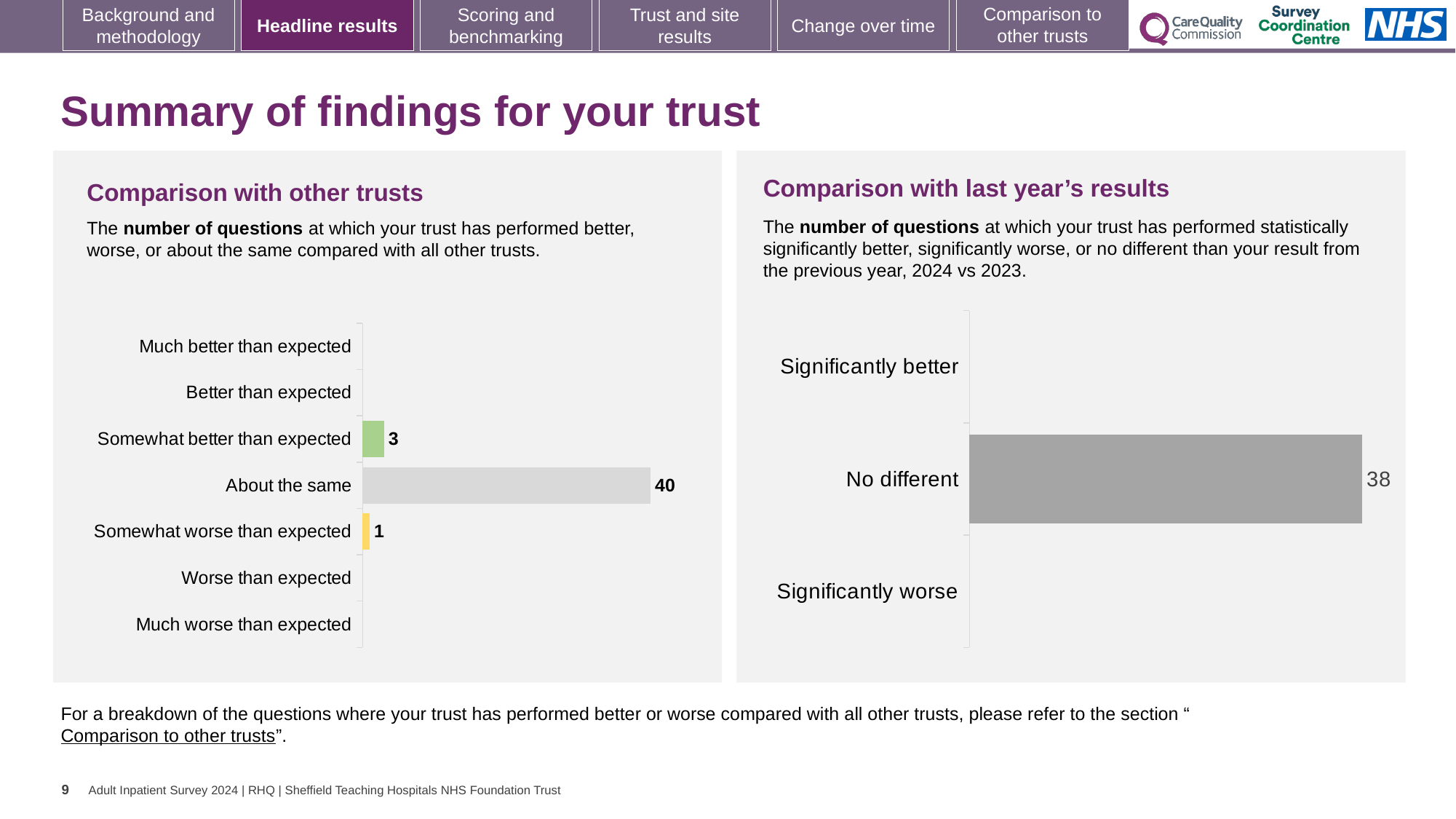
How many categories are listed on the y axis of the 'Comparison with other trusts' chart? 7 What kind of chart is the 'Comparison with other trusts' chart? Bar chart How many categories are listed on the y axis of the 'Comparison with last year's results' chart? 3 In the 'Comparison with last year's results' chart, what is the value for 'No different'? 38 In the 'Comparison with other trusts' chart, how many questions were 'About the same'? 40 In the 'Comparison with other trusts' chart, what is the difference between 'About the same' and 'Somewhat better than expected'? 37 In the 'Comparison with other trusts' chart, what colour is the bar for 'Somewhat better than expected'? Green In the 'Comparison with other trusts' chart, which is larger: 'Somewhat better than expected' or 'Somewhat worse than expected'? Somewhat better than expected In the 'Comparison with last year's results' chart, which category has the highest value? No different In the 'Comparison with other trusts' chart, what is the value for 'Somewhat better than expected'? 3 In the 'Comparison with other trusts' chart, which category has the highest value? About the same In the 'Comparison with other trusts' chart, what is the value for 'Somewhat worse than expected'? 1